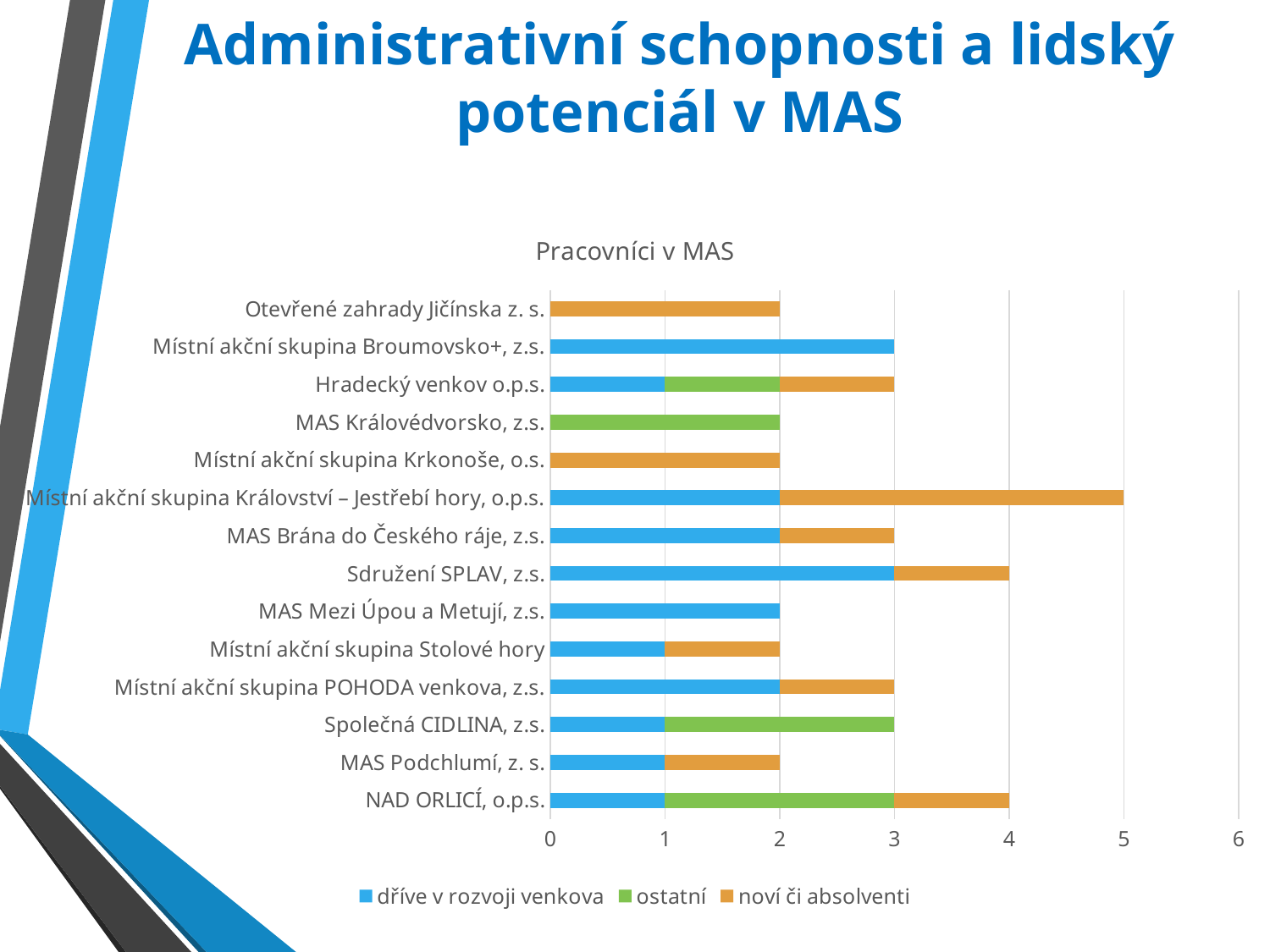
Which organisation has the longest total bar in the chart? Místní akční skupina Království – Jestřebí hory, o.p.s. What is the value of the 'noví či absolventi' segment for Místní akční skupina Království – Jestřebí hory, o.p.s.? 3 Which has a longer total bar: NAD ORLICÍ, o.p.s. or MAS Podchlumí, z. s.? NAD ORLICÍ, o.p.s. How many series does the legend of the 'Pracovníci v MAS' chart list? 3 What is the total bar length for Sdružení SPLAV, z.s.? 4 What is the difference between the total bar for Sdružení SPLAV, z.s. and the total bar for MAS Mezi Úpou a Metují, z.s.? 2 What kind of chart is shown on the slide? stacked bar chart What is the value of the 'ostatní' segment for Společná CIDLINA, z.s.? 2 How many organisations (categories) are shown on the y axis of the chart? 14 What is the value of the 'dříve v rozvoji venkova' segment for Místní akční skupina Broumovsko+, z.s.? 3 What is the title of the chart on the slide? Pracovníci v MAS What is the total bar length for Místní akční skupina Království – Jestřebí hory, o.p.s.? 5